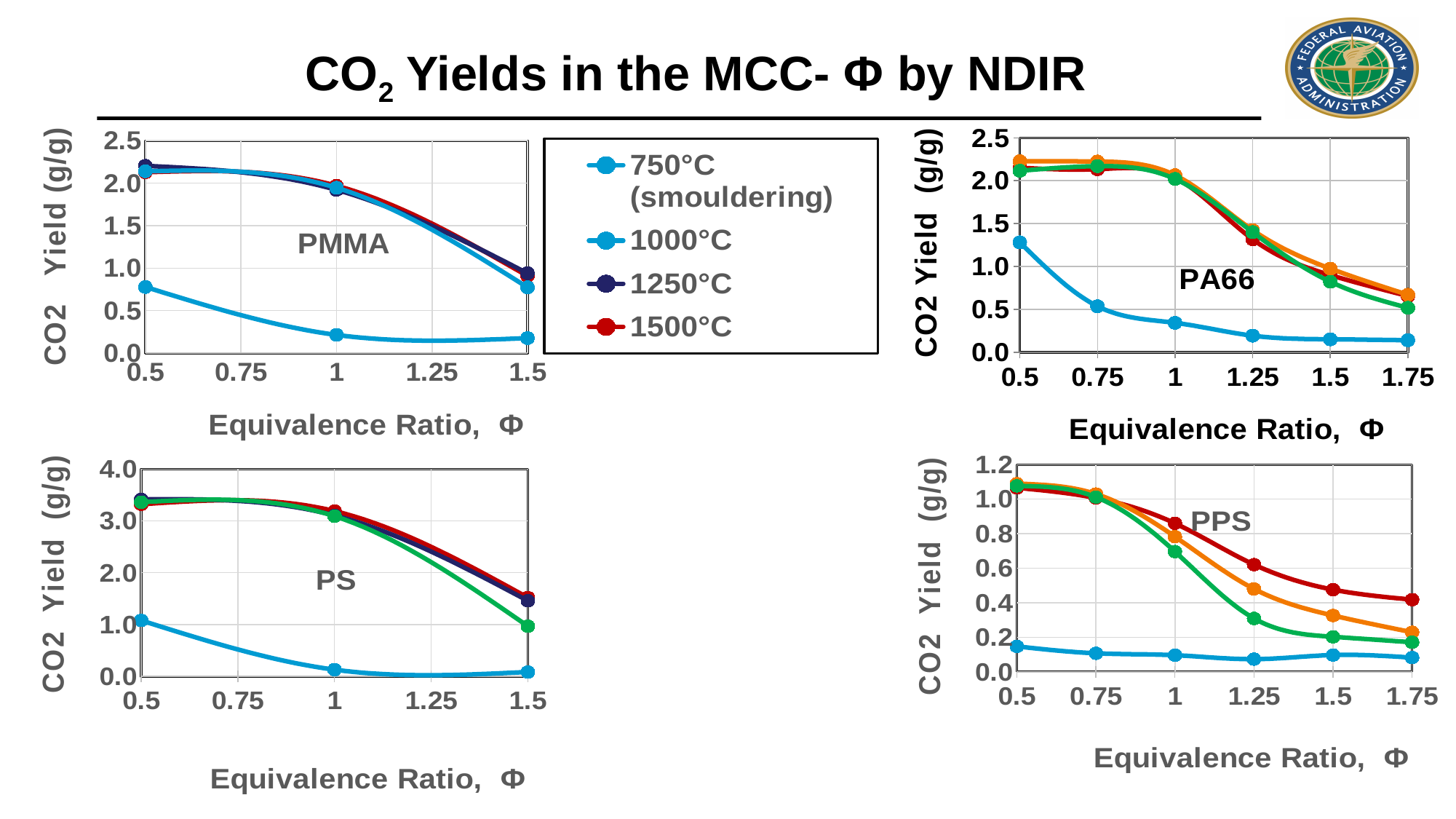
In the PMMA chart, how many equivalence ratio points are plotted for each series? 3 What is the x-axis label on the PA66 chart? Equivalence Ratio, Φ In the PS chart, do the CO2 yields rise or fall as the equivalence ratio increases? fall In the PMMA chart, at equivalence ratio 1.5, which is larger: the 750°C (smouldering) value or the 1500°C value? 1500°C In the PS chart, at equivalence ratio 1, which is larger: the 750°C (smouldering) value or the 1500°C value? 1500°C How many series does the legend list? 4 What kind of chart is the PMMA chart at the top left of the slide? line chart In the PPS chart, is the 1500°C value at equivalence ratio 1.75 greater or less than 0.5? less How many charts are shown on the slide? 4 In the PA66 chart, is the 750°C (smouldering) value at equivalence ratio 0.5 greater or less than 1.0? greater In the PMMA chart, is the 750°C (smouldering) value at equivalence ratio 0.5 greater or less than 1.0? less In the PA66 chart, how many equivalence ratio points are plotted for each series? 6